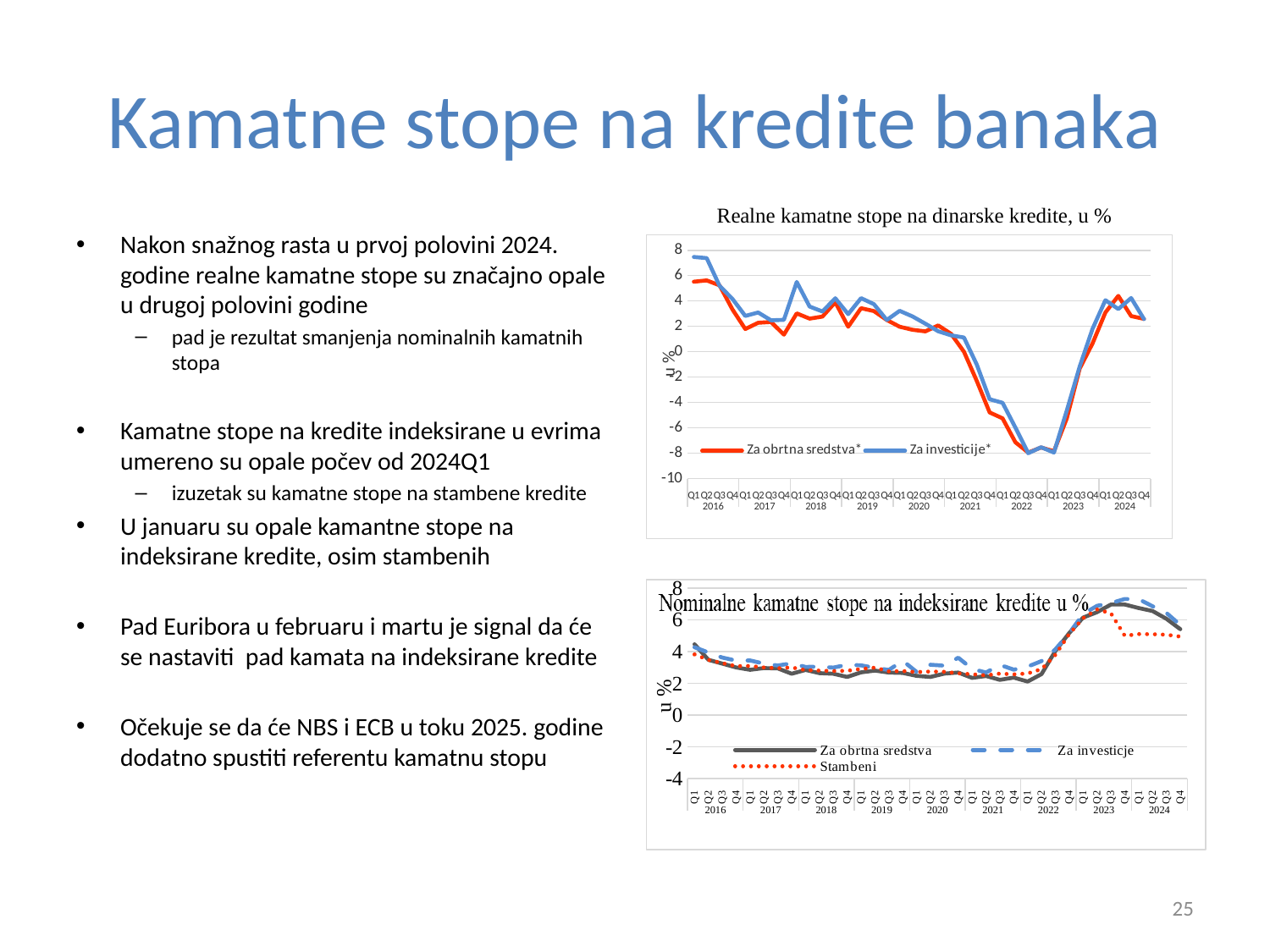
How many series does the legend of the bottom chart (Nominalne kamatne stope na indeksirane kredite) list? 3 In the top chart (Realne kamatne stope na dinarske kredite), do the values rise or fall between Q1 2021 and Q4 2022? fall In the bottom chart (Nominalne kamatne stope na indeksirane kredite), which series is drawn with a dotted red line? Stambeni How many series does the legend of the top chart (Realne kamatne stope na dinarske kredite) list? 2 What kind of chart is the bottom chart titled "Nominalne kamatne stope na indeksirane kredite u %"? line chart In the bottom chart (Nominalne kamatne stope na indeksirane kredite), is the value for Stambeni in Q4 2024 greater or less than 6? less In the bottom chart (Nominalne kamatne stope na indeksirane kredite), do the values for Za obrtna sredstva rise or fall between Q1 2022 and Q4 2023? rise What kind of chart is the top chart titled "Realne kamatne stope na dinarske kredite, u %"? line chart In the top chart (Realne kamatne stope na dinarske kredite), which series has the higher value in Q1 2016, Za obrtna sredstva* or Za investicije*? Za investicije* In the top chart (Realne kamatne stope na dinarske kredite), is the value for Za obrtna sredstva* in Q3 2022 greater or less than -6? less In the top chart (Realne kamatne stope na dinarske kredite), is the value for Za investicije* in Q1 2016 greater or less than 6? greater In the bottom chart (Nominalne kamatne stope na indeksirane kredite), which series has the higher value in Q4 2024, Stambeni or Za investicije? Za investicije